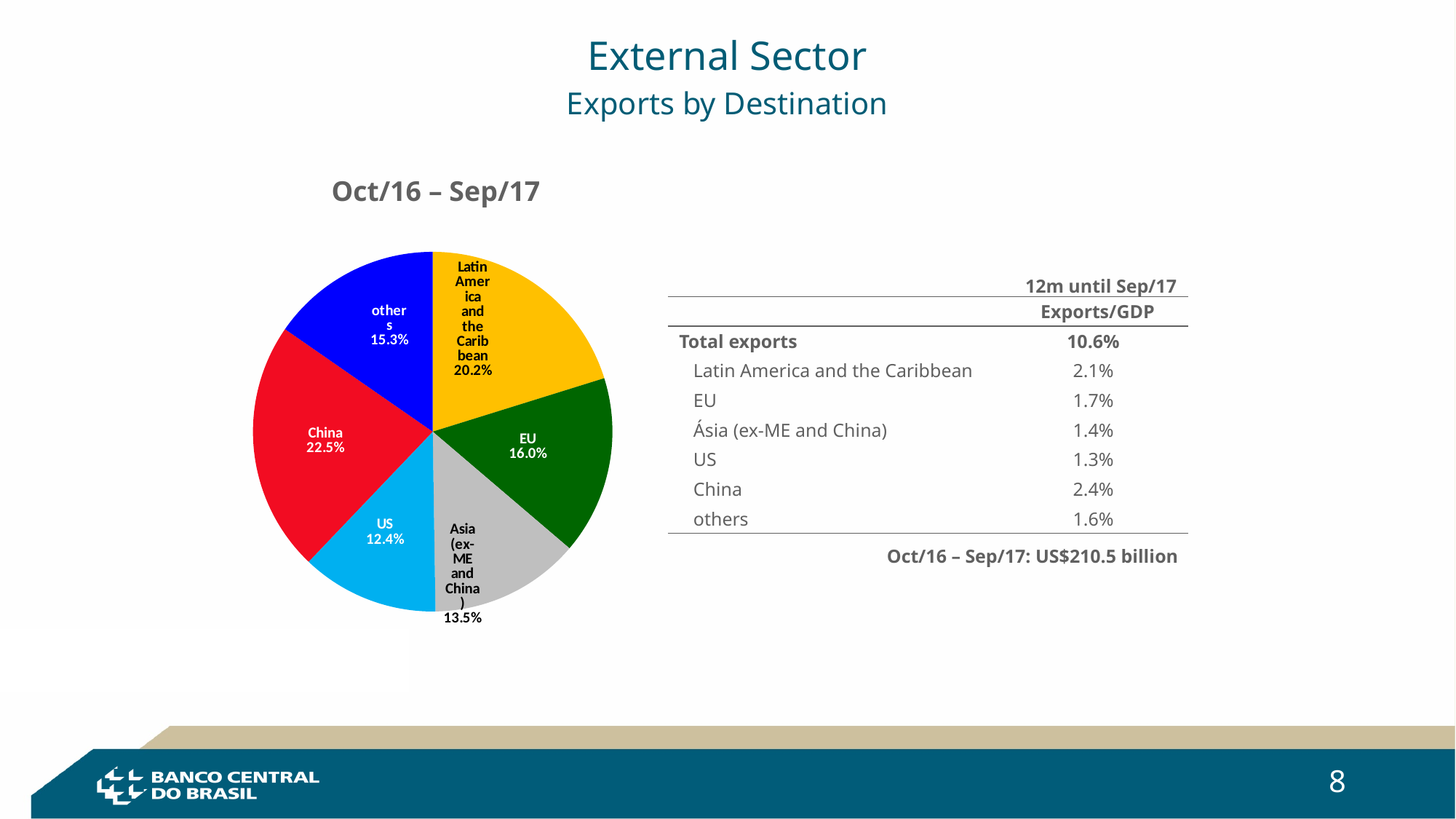
What is the title of the pie chart? Oct/16 – Sep/17 Which destination has the largest slice in the pie chart? China Which destination has the smallest slice in the pie chart? US What share of exports goes to the US according to the pie chart? 12.4% In the pie chart, which is larger: the share for others or the share for Asia (ex-ME and China)? others What colour is the China slice in the pie chart? red What share of exports goes to Latin America and the Caribbean according to the pie chart? 20.2% In the pie chart, what is the difference between the China share and the US share? 10.1% What share of exports goes to China according to the pie chart? 22.5% What share of exports goes to the EU according to the pie chart? 16.0% What type of chart is shown on the slide? pie chart How many slices does the pie chart have? 6